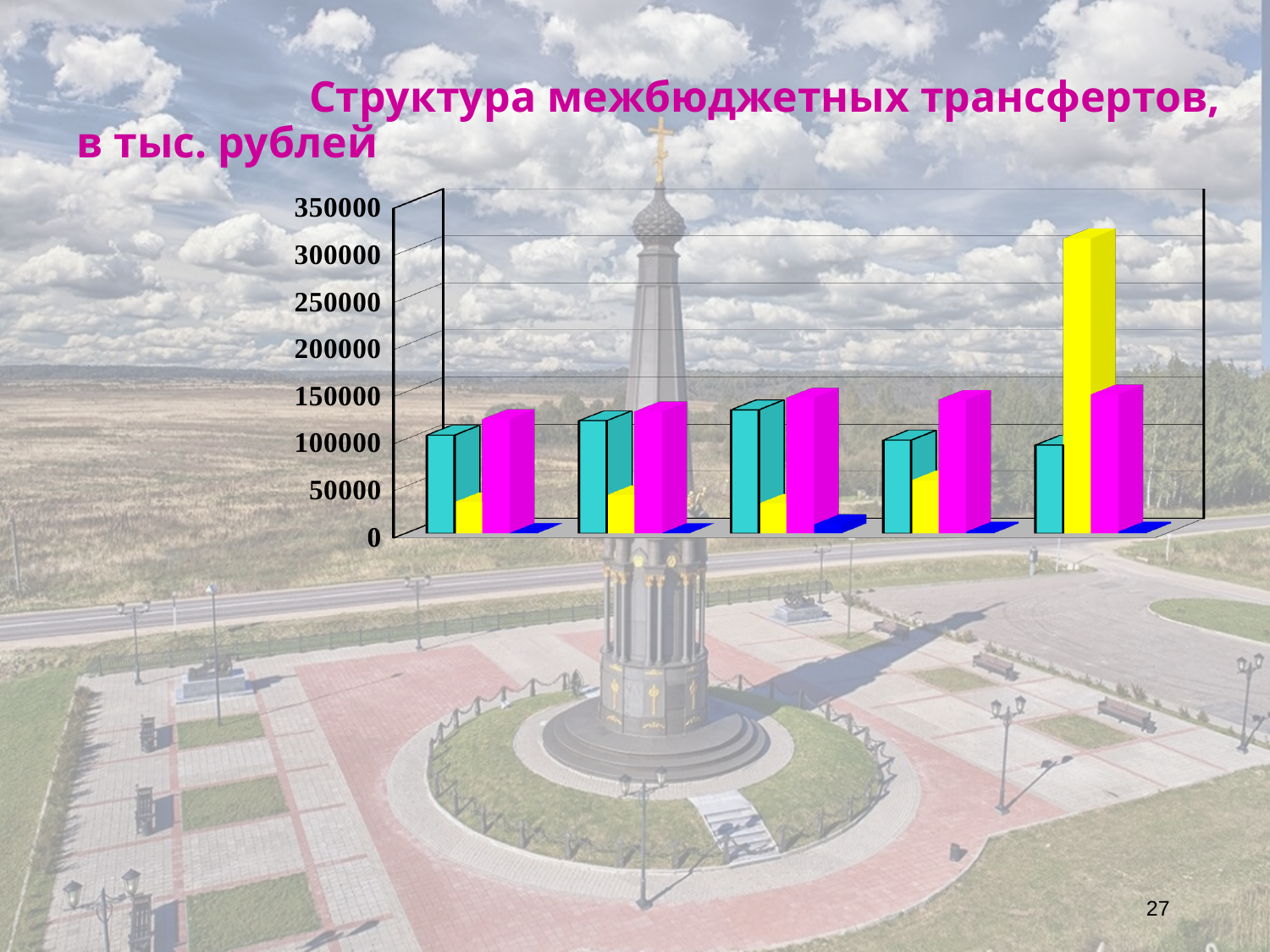
Is the yellow bar in the rightmost group greater or less than 300000? greater Is the cyan bar in the third group from the left greater or less than 100000? greater What kind of chart is shown on the slide? bar chart How many groups of bars are plotted along the x axis? 5 Which bar is the tallest in the whole chart? the yellow bar in the rightmost group What is the highest value shown on the vertical axis? 350000 What is the title of the chart? Структура межбюджетных трансфертов, в тыс. рублей In the rightmost group, which is larger: the yellow bar or the magenta bar? the yellow bar How many bars are there in each group? 4 Which is larger: the cyan bar in the third group from the left or the cyan bar in the rightmost group? the cyan bar in the third group Is the blue bar in the third group from the left greater or less than 50000? less